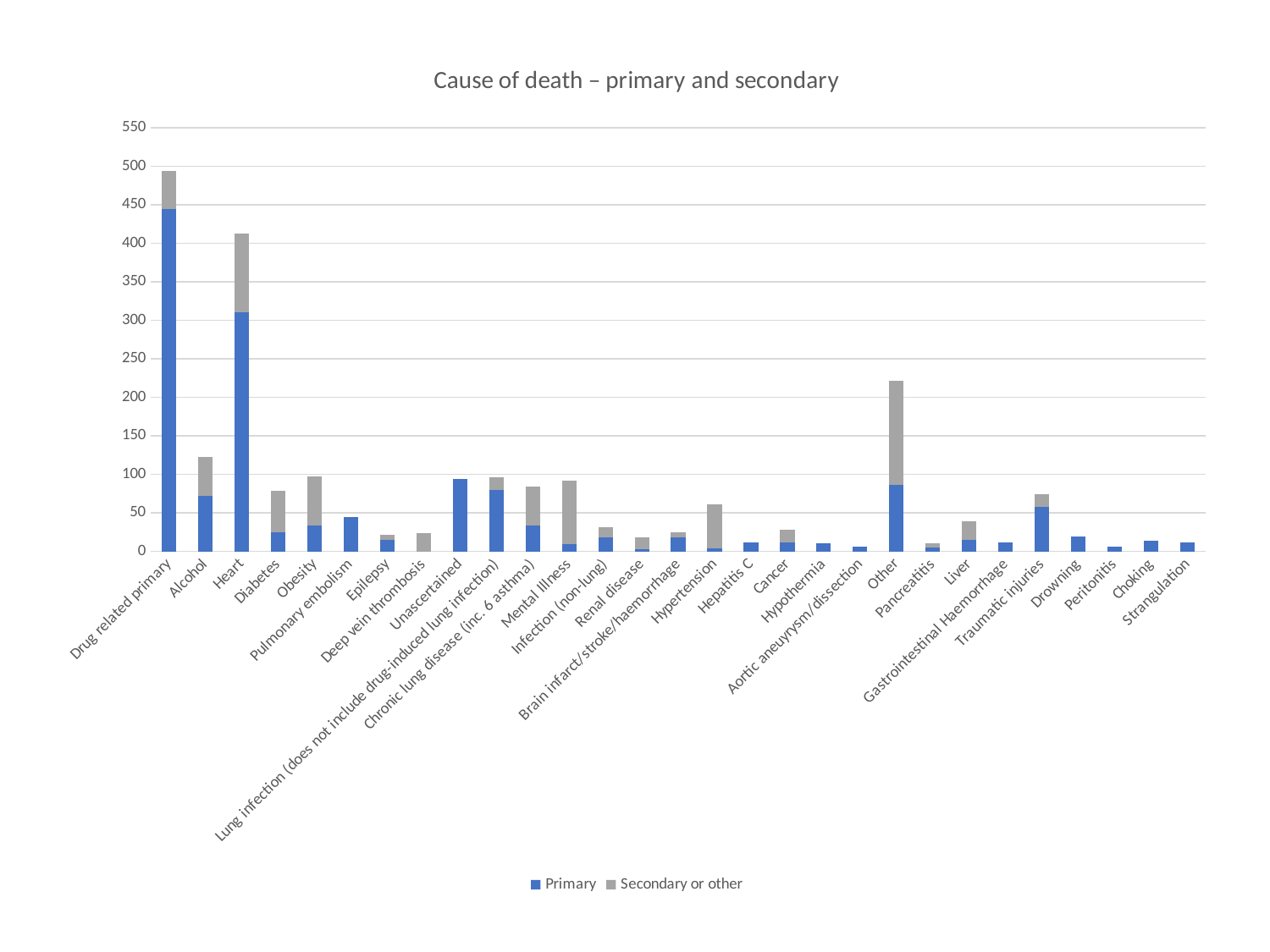
How many series does the legend list? 2 Which category has the tallest stacked bar overall? Drug related primary Which has the larger total stacked bar, Heart or Alcohol? Heart Is the total stacked value for Drug related primary greater or less than 450? greater Is the Primary value for Hypertension greater or less than 50? less Is the total stacked value for Other greater or less than 200? greater How many cause-of-death categories are plotted on the x axis? 29 What kind of chart is shown on the slide? stacked bar chart What is the title of the chart? Cause of death – primary and secondary Which category has the largest 'Secondary or other' segment? Other What are the two series named in the legend? Primary; Secondary or other